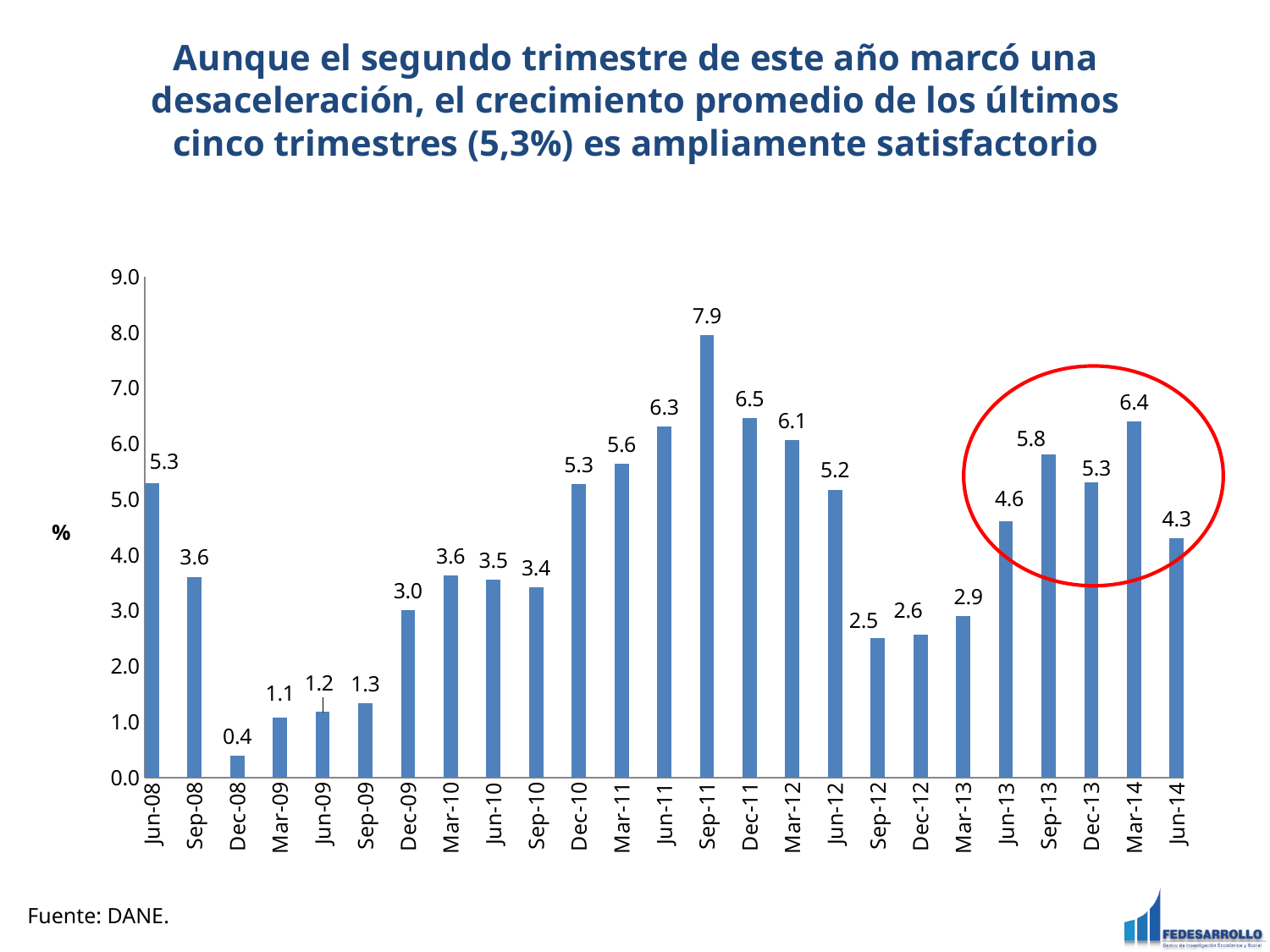
How many bars are plotted in the chart? 25 Which quarter has the lowest value? Dec-08 Is the value for Dec-11 greater or less than 6.0? greater What is the source cited below the chart? DANE Do the values rise or fall from Dec-08 to Sep-09? Rise What is the value for Dec-12? 2.6 What kind of chart is shown on the slide? Bar chart Which is larger, the value for Jun-13 or the value for Sep-13? Sep-13 What is the difference between the values for Mar-14 and Jun-14? 2.1 Which quarter has the highest value? Sep-11 What is the value for Sep-11? 7.9 What is the value for Jun-14? 4.3